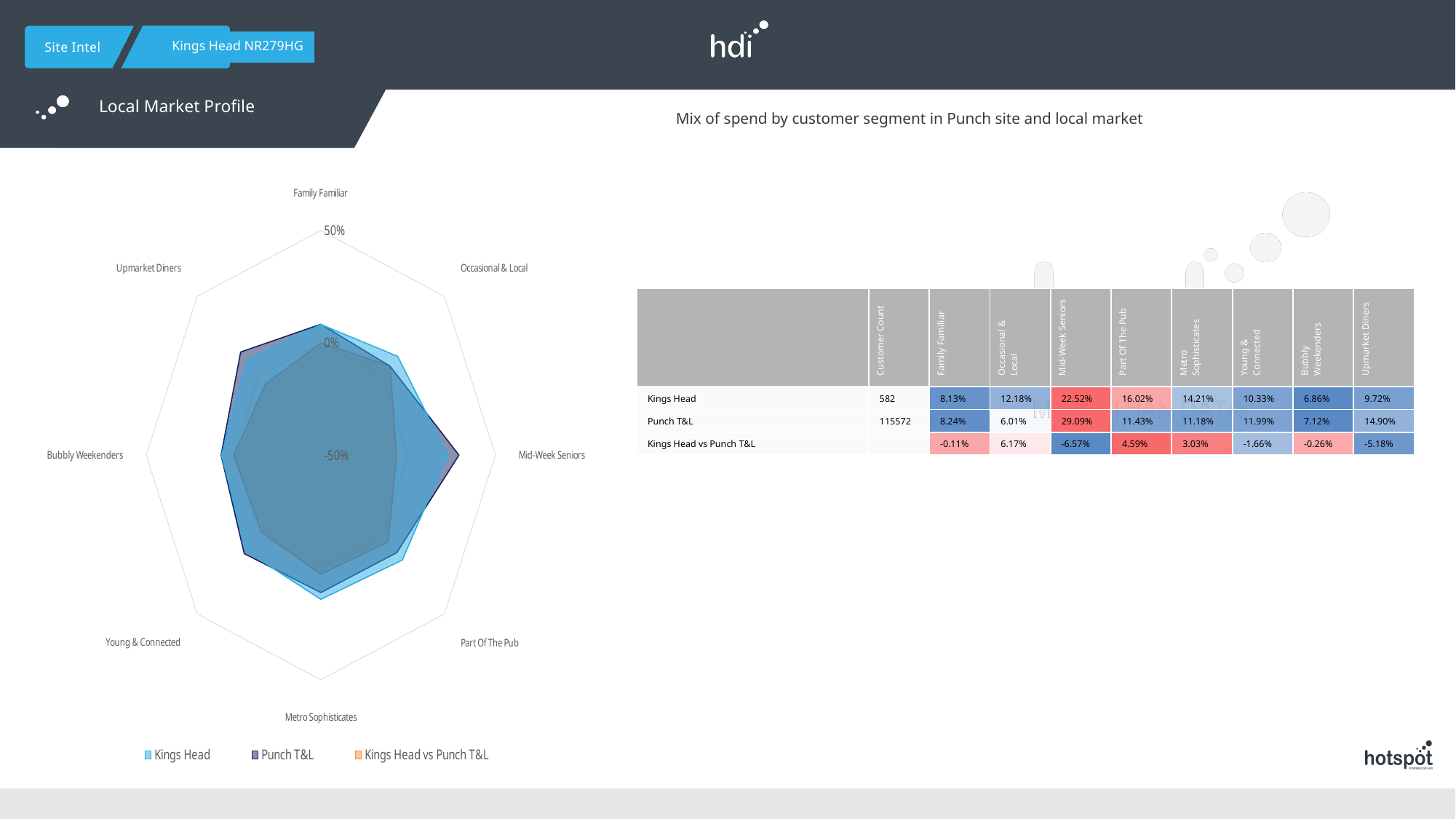
Which customer segment has the highest Kings Head value? Mid-Week Seniors What is the Kings Head vs Punch T&L difference for Part Of The Pub? 4.59% What is the Punch T&L value for Upmarket Diners? 14.90% How many customer segments are plotted around the radar chart? 8 What is the Kings Head value for Mid-Week Seniors? 22.52% What is the Customer Count for Kings Head in the table? 582 How many series does the legend of the radar chart list? 3 Which customer segment has the highest Punch T&L value? Mid-Week Seniors For Occasional & Local, which is larger: Kings Head or Punch T&L? Kings Head What kind of chart is shown on the left of the slide? Radar chart What is the highest axis value labelled on the radar chart? 50% Which customer segment has the lowest Kings Head value? Bubbly Weekenders